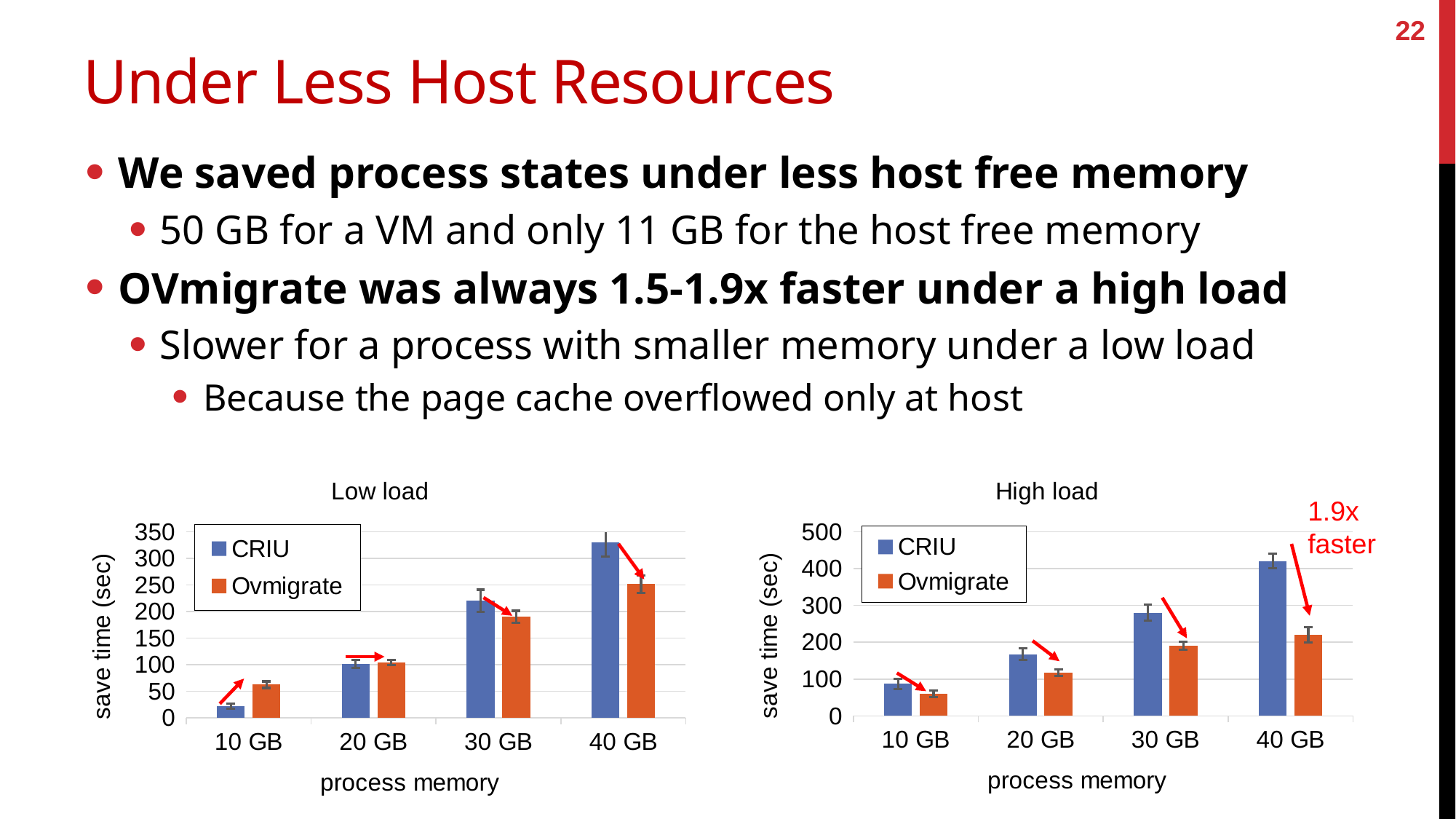
In the "High load" chart, is the CRIU save time at 40 GB greater or less than 400? greater In the "High load" chart, which process memory category has the highest CRIU save time? 40 GB What is the y-axis label of the "Low load" chart? save time (sec) In the "High load" chart, at 40 GB, which series has the larger save time, CRIU or Ovmigrate? CRIU What kind of chart is the "Low load" chart? bar chart In the "Low load" chart, is the Ovmigrate save time at 40 GB greater or less than 300? less How many series does the legend of the "High load" chart list? 2 In the "Low load" chart, which process memory category has the lowest CRIU save time? 10 GB How many process memory categories are shown on the x axis of the "Low load" chart? 4 In the "High load" chart, is the Ovmigrate save time at 30 GB greater or less than 100? greater In the "Low load" chart, at 10 GB, which series has the larger save time, CRIU or Ovmigrate? Ovmigrate In the "High load" chart, do the CRIU save times rise or fall as process memory increases from 10 GB to 40 GB? rise